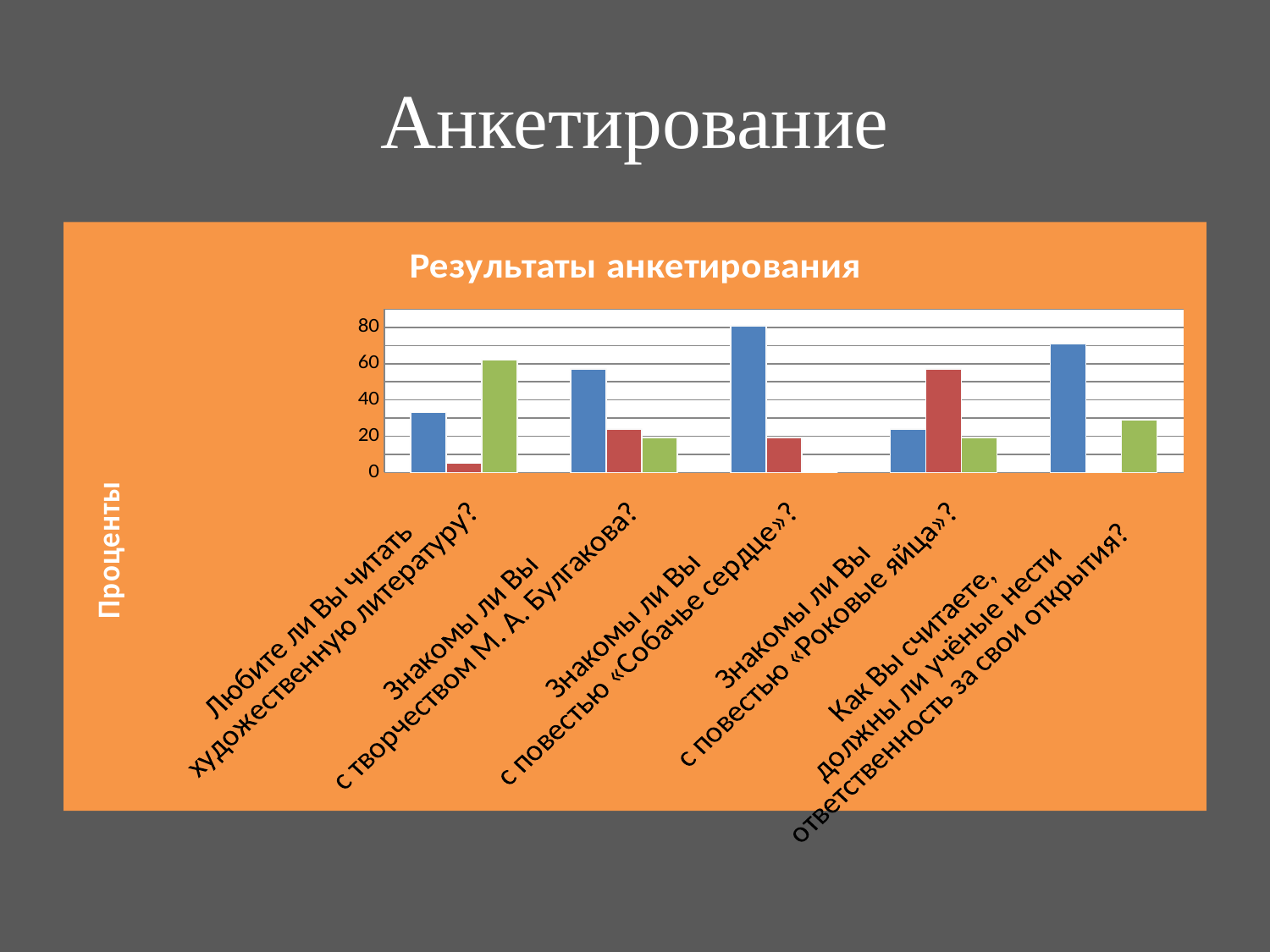
How many survey questions (categories) are shown along the x axis of the chart? 5 Is the red bar for «Любите ли Вы читать художественную литературу?» greater or less than 20? less Is the blue bar for «Знакомы ли Вы с повестью «Собачье сердце»?» greater or less than 60? greater What is the label of the vertical axis of the chart? Проценты How many differently coloured bar series are plotted in the chart? 3 For «Любите ли Вы читать художественную литературу?», which bar is taller: the blue one or the green one? the green one Is the green bar for «Любите ли Вы читать художественную литературу?» greater or less than 40? greater For «Знакомы ли Вы с повестью «Роковые яйца»?», which bar is taller: the blue one or the red one? the red one What is the title of the chart? Результаты анкетирования For which survey question is the blue bar the tallest? Знакомы ли Вы с повестью «Собачье сердце»? What kind of chart is shown on the slide? bar chart